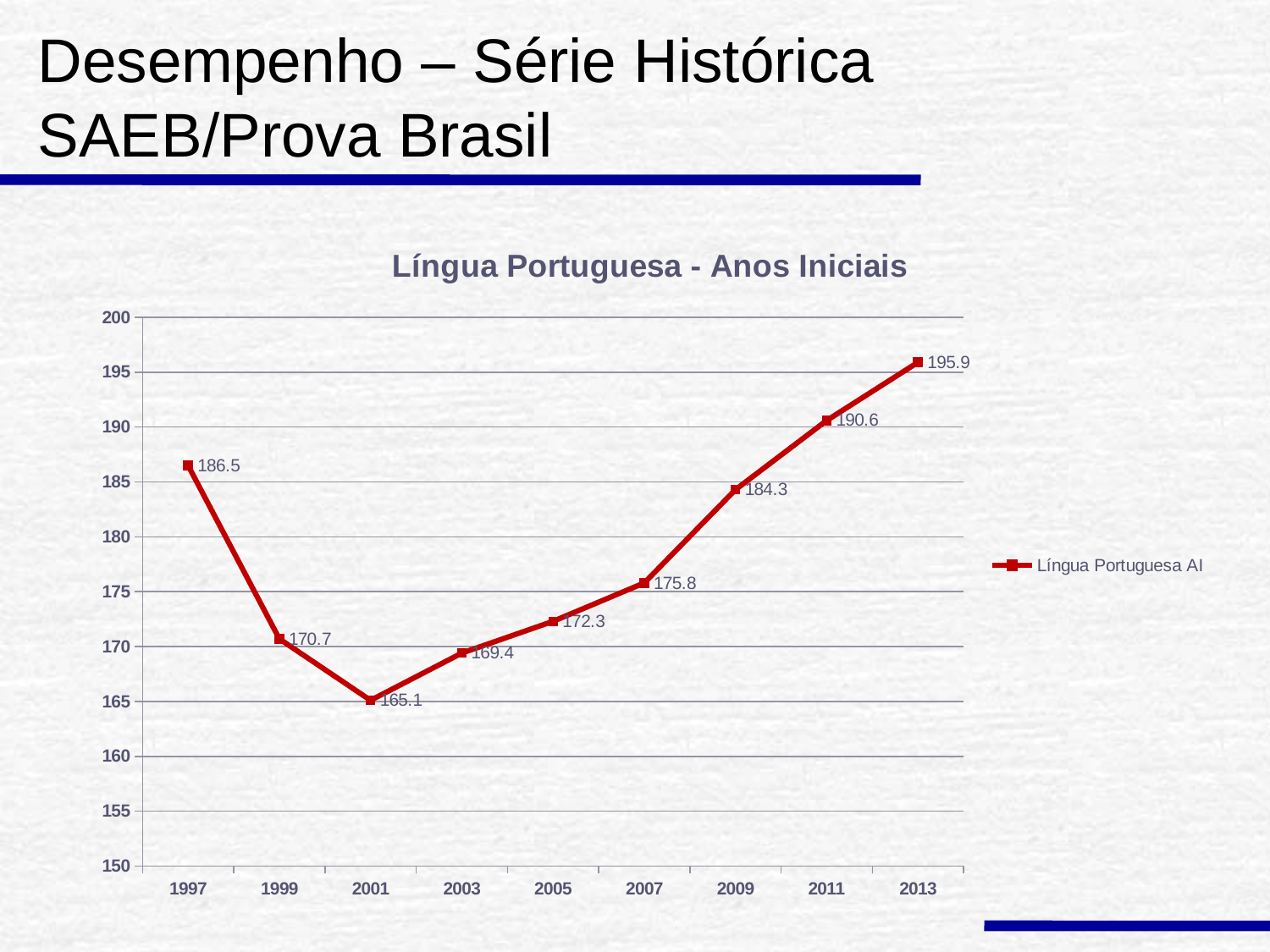
How many years are plotted on the chart? 9 What is the difference between the values for 2013 and 2011? 5.3 What kind of chart is shown? line chart Which year has the highest value? 2013 What is the title of the chart? Língua Portuguesa - Anos Iniciais How many series does the legend list? 1 What is the value for 2013? 195.9 What is the value for 2005? 172.3 Which year has the lowest value? 2001 Is the value for 2009 greater or less than 180? greater What is the value for 1997? 186.5 Which is larger, the value for 1999 or the value for 2003? 1999